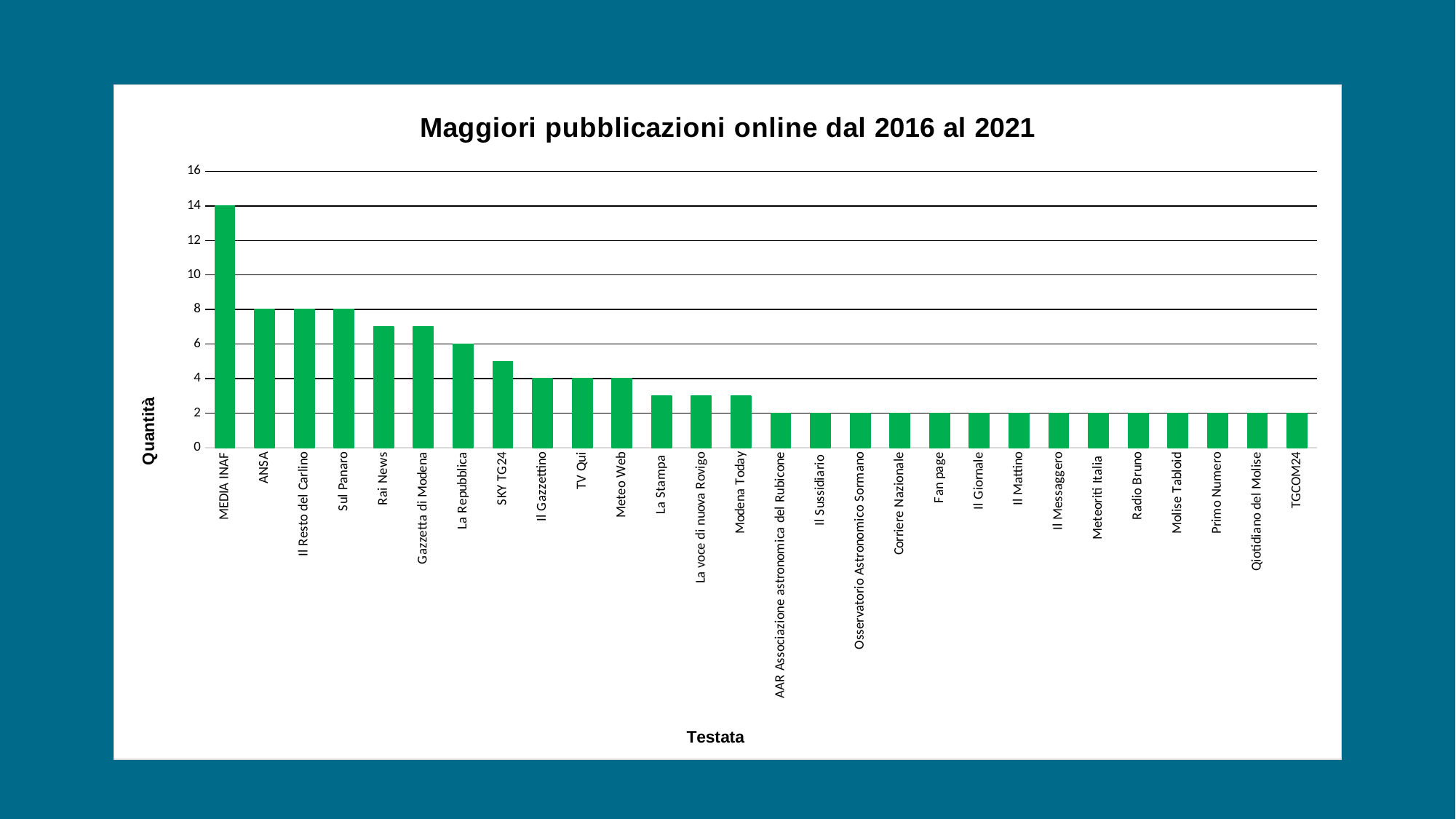
Is the value for La Stampa greater or less than 4? less What is the value for MEDIA INAF? 14 What kind of chart is shown on the slide? bar chart Which testata has the highest value in the chart? MEDIA INAF What is the title of the chart? Maggiori pubblicazioni online dal 2016 al 2021 What is the value for TGCOM24? 2 How many testate (categories) are shown on the x axis? 28 What is the value for ANSA? 8 What is the value for La Repubblica? 6 Is the value for Rai News greater or less than 6? greater What is the difference between the values for MEDIA INAF and ANSA? 6 Which is larger, the value for La Repubblica or the value for Il Gazzettino? La Repubblica